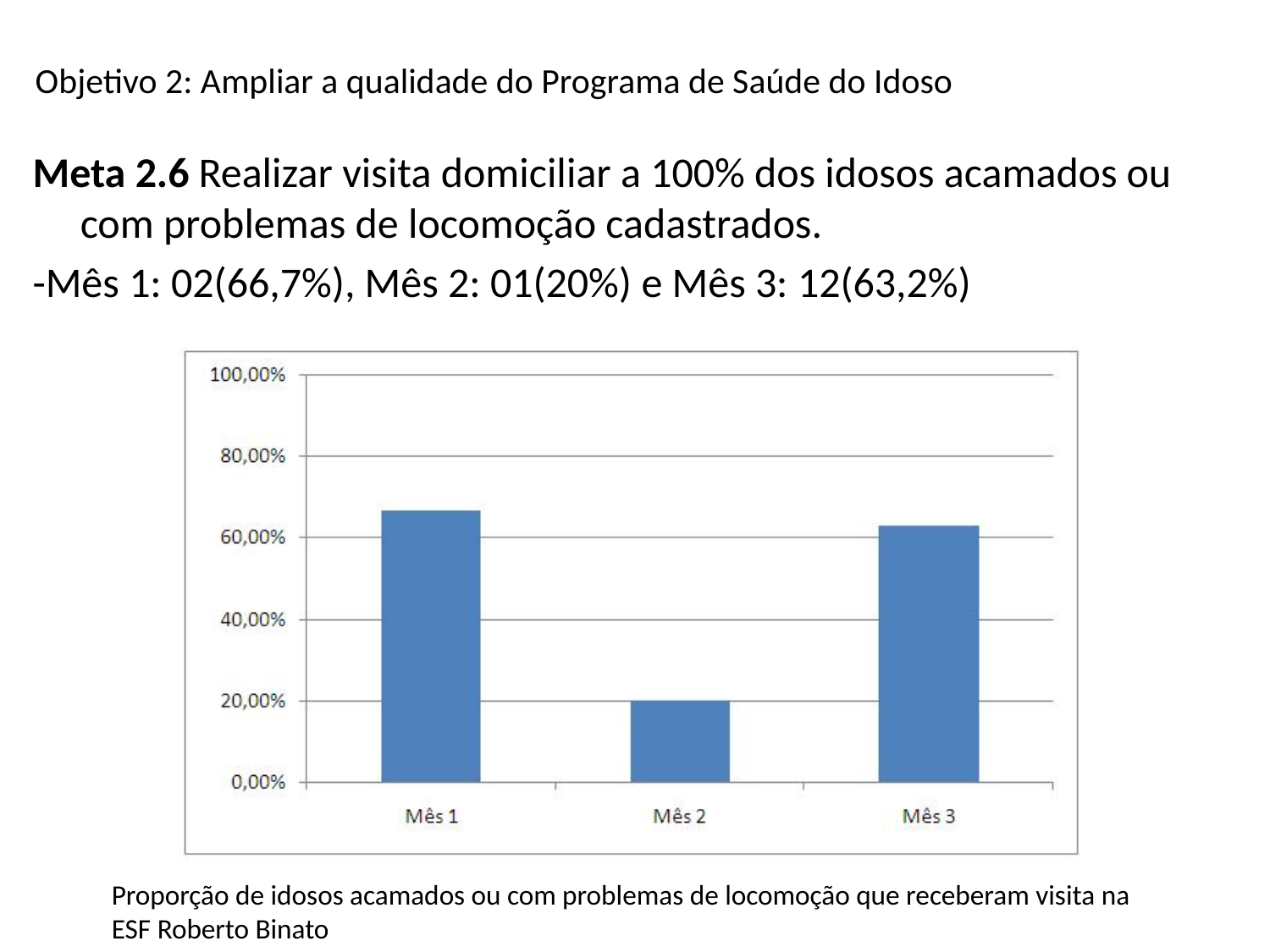
What is the difference between the values for Mês 1 and Mês 2? 46,7 percentage points Which month has the lowest bar in the chart? Mês 2 What is the value for Mês 2 in the chart? 20% What is the value for Mês 3 according to the slide? 63,2% Is the value for Mês 2 greater or less than 40,00%? less What is the value for Mês 1 according to the slide? 66,7% What kind of chart is shown on the slide? bar chart How many months (categories) are plotted on the x axis of the chart? 3 Is the value for Mês 1 greater or less than 60,00%? greater Which is larger, the value for Mês 1 or the value for Mês 3? Mês 1 Which month has the highest bar in the chart? Mês 1 Do the values rise or fall from Mês 1 to Mês 2? fall